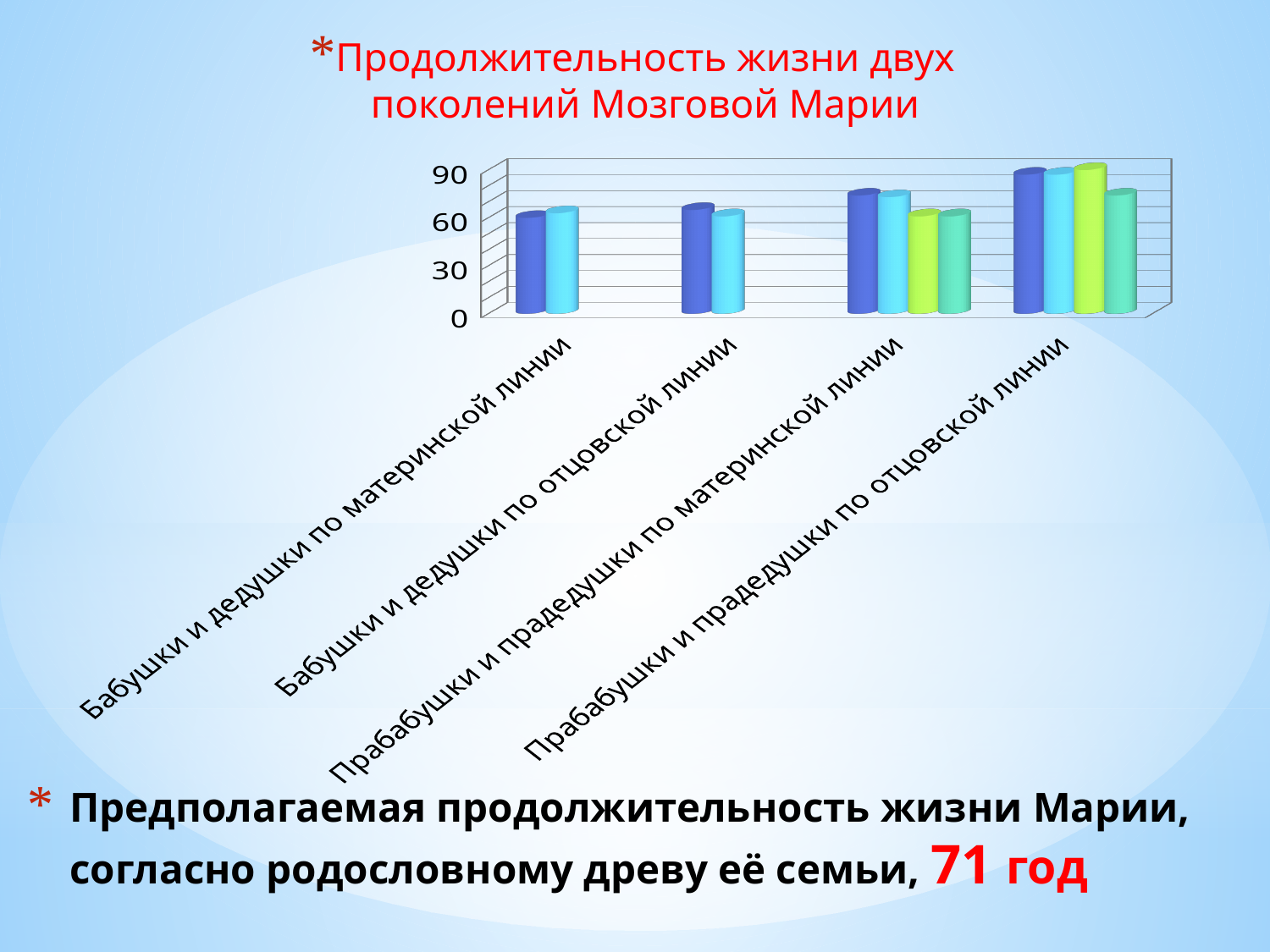
How many bars are plotted for the category 'Бабушки и дедушки по материнской линии'? 2 Is the value of the first bar for 'Бабушки и дедушки по отцовской линии' greater or less than 30? greater What is the title of the chart on the slide? Продолжительность жизни двух поколений Мозговой Марии What is the highest tick value shown on the vertical axis of the chart? 90 How many categories are shown on the x axis of the chart? 4 Is the value of the first bar for 'Бабушки и дедушки по материнской линии' greater or less than 90? less How many bars are plotted for the category 'Прабабушки и прадедушки по отцовской линии'? 4 Which is larger: the first bar for 'Прабабушки и прадедушки по отцовской линии' or the first bar for 'Бабушки и дедушки по материнской линии'? Прабабушки и прадедушки по отцовской линии Is the value of the first bar for 'Прабабушки и прадедушки по отцовской линии' greater or less than 60? greater Which category has the tallest bars in the chart? Прабабушки и прадедушки по отцовской линии What kind of chart is shown on the slide? bar chart